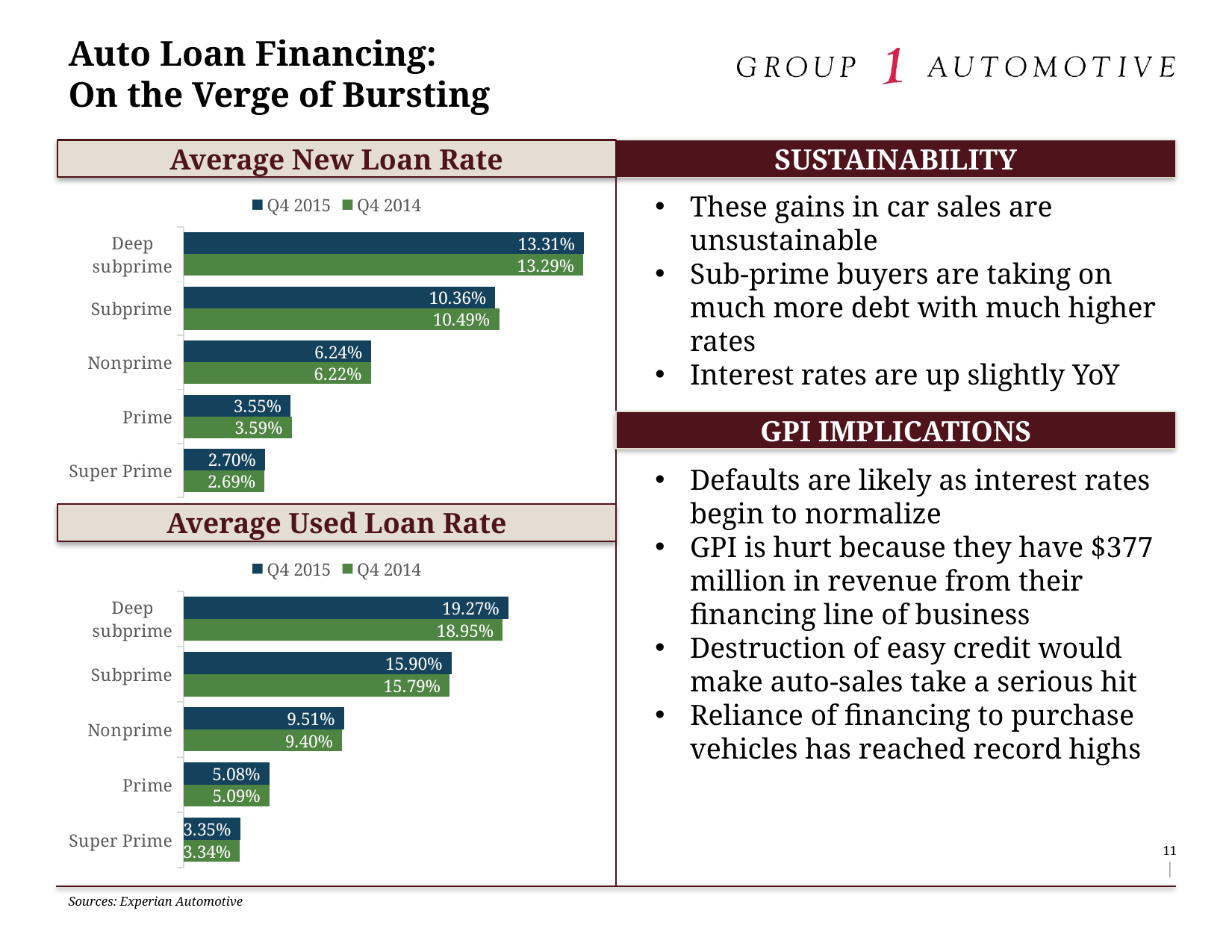
Which series is shown in green in the Average New Loan Rate chart? Q4 2014 What type of chart is the Average Used Loan Rate chart? Bar chart In the Average Used Loan Rate chart, what is the difference between the Q4 2015 and Q4 2014 rates for Deep subprime? 0.32% How many series does the legend of the Average New Loan Rate chart list? 2 In the Average Used Loan Rate chart, what is the Q4 2015 rate for Nonprime? 9.51% In the Average New Loan Rate chart, what is the Q4 2015 rate for Deep subprime? 13.31% In the Average New Loan Rate chart, which category has the lowest Q4 2015 rate? Super Prime In the Average New Loan Rate chart, which is larger for Subprime: the Q4 2015 rate or the Q4 2014 rate? Q4 2014 In the Average Used Loan Rate chart, which category has the highest Q4 2015 rate? Deep subprime How many categories are shown in the Average Used Loan Rate chart? 5 In the Average New Loan Rate chart, what is the Q4 2014 rate for Prime? 3.59% In the Average Used Loan Rate chart, what is the Q4 2014 rate for Subprime? 15.79%